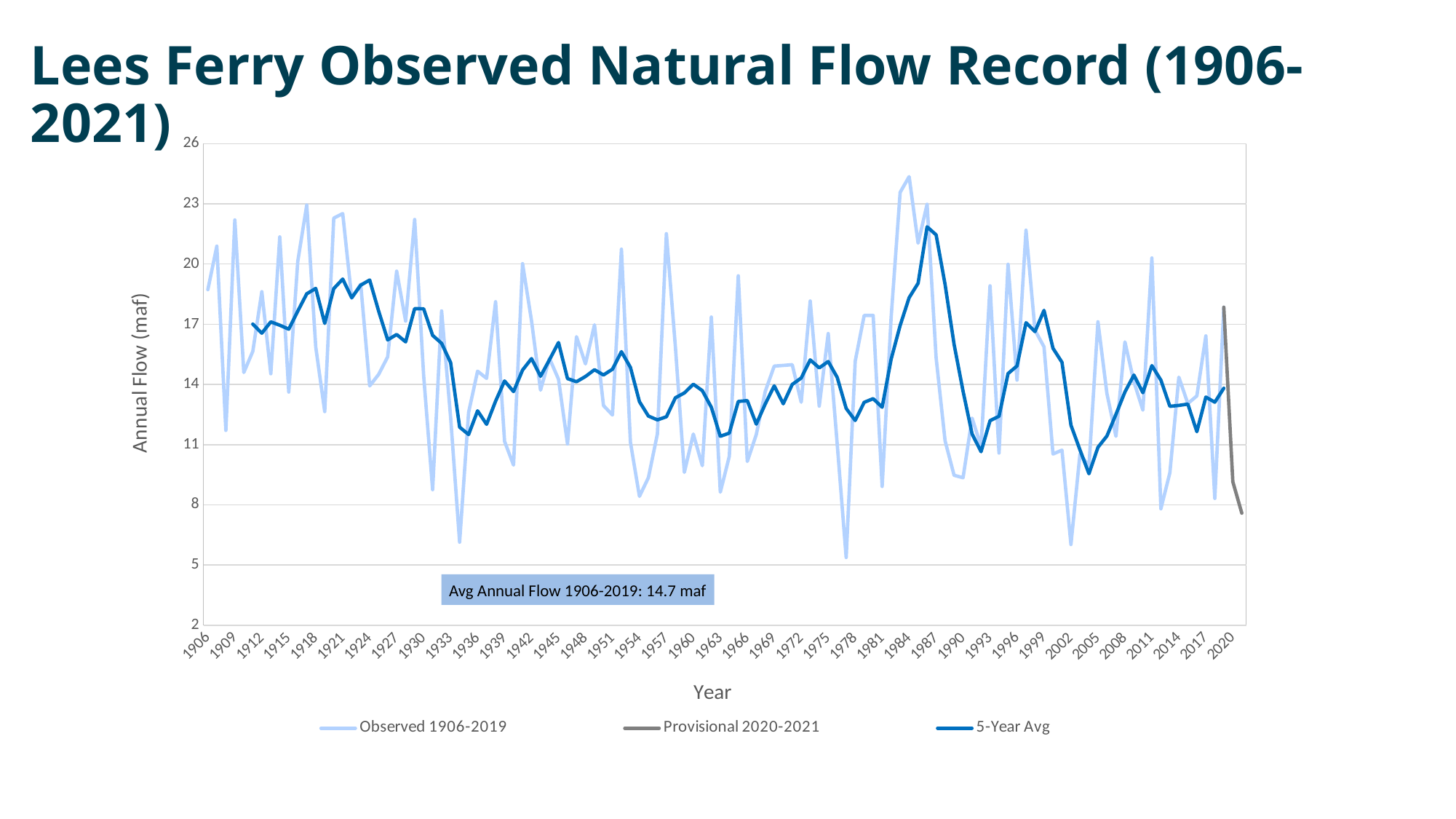
What is the title of the chart? Lees Ferry Observed Natural Flow Record (1906-2021) How many series does the legend list? 3 Is the Provisional 2020-2021 value at 2021 greater or less than 8? less Is the Observed 1906-2019 value at 1906 greater or less than 17? greater Which is larger, the 5-Year Avg value at 1987 or at 2002? 1987 Is the 5-Year Avg value at 1987 greater or less than 20? greater What average annual flow for 1906-2019 is stated in the text box on the chart? 14.7 maf What kind of chart is shown on the slide? line chart Which is larger, the Observed 1906-2019 value at 1984 or at 1906? 1984 What is the label on the vertical axis? Annual Flow (maf) Does the 5-Year Avg rise or fall between 1987 and 1990? fall